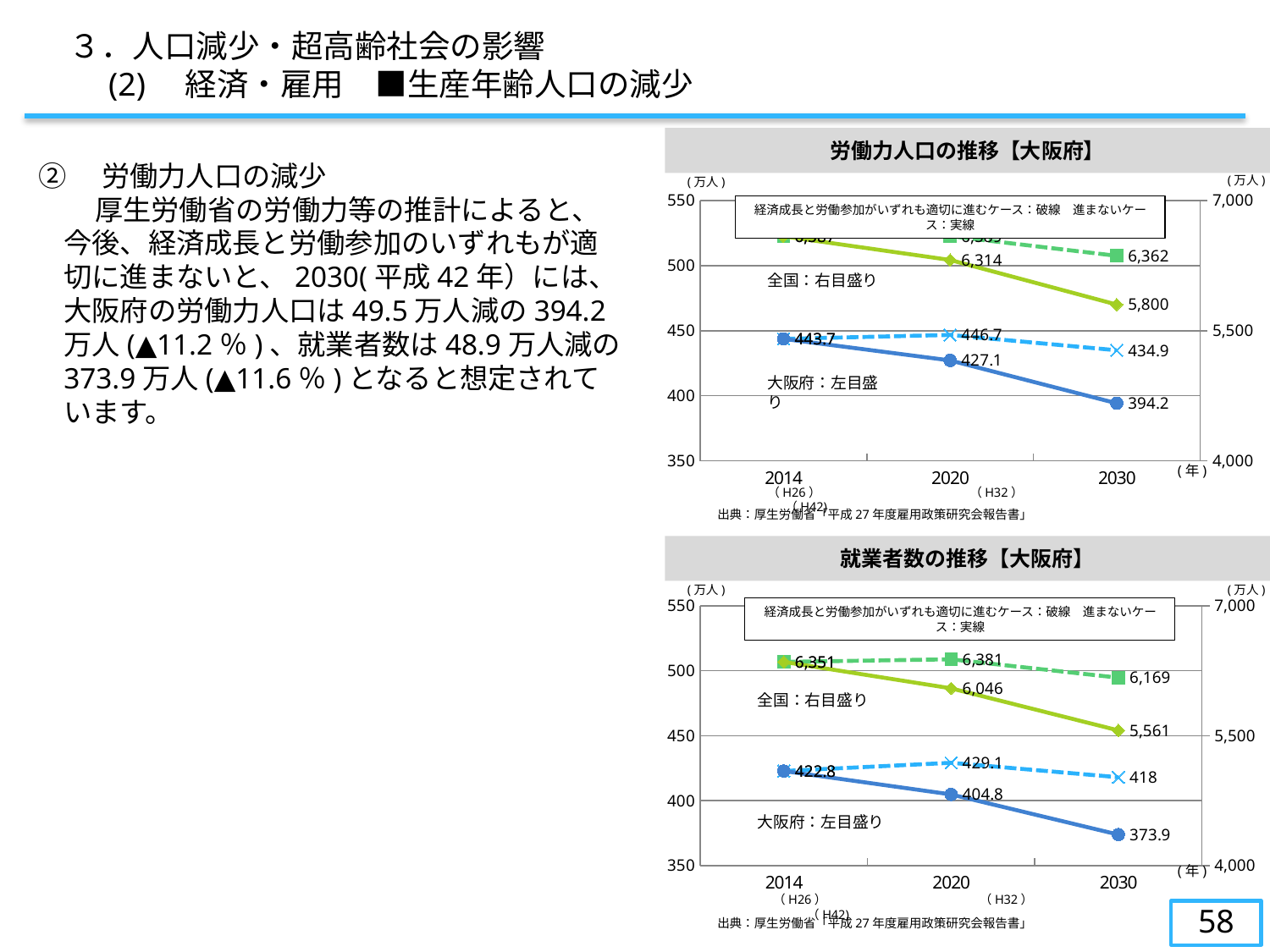
In the bottom chart (就業者数の推移【大阪府】), what is the 全国 value in 2020 on the dashed line? 6,381 In the top chart (労働力人口の推移【大阪府】), what is the value for 大阪府 in 2030 in the case where growth and participation do not progress (solid line)? 394.2 What kind of chart is the bottom chart (就業者数の推移【大阪府】)? line chart In the top chart (労働力人口の推移【大阪府】), what is the 全国 value in 2030 on the solid line? 5,800 In the top chart (労働力人口の推移【大阪府】), what is the difference between the 大阪府 dashed-line value and solid-line value in 2030? 40.7 In the top chart (労働力人口の推移【大阪府】), what is the 全国 value in 2030 on the dashed line? 6,362 In the top chart (労働力人口の推移【大阪府】), what is the value for 大阪府 in 2020 on the solid line? 427.1 In the bottom chart (就業者数の推移【大阪府】), does the 大阪府 solid line rise or fall from 2014 to 2030? fall How many years are plotted on the x axis of the top chart (労働力人口の推移【大阪府】)? 3 In the bottom chart (就業者数の推移【大阪府】), what is the difference between the 全国 solid-line values in 2014 and 2030? 790 In the bottom chart (就業者数の推移【大阪府】), which is larger in 2030: the 大阪府 dashed-line value or the solid-line value? dashed-line value (418) In the bottom chart (就業者数の推移【大阪府】), what is the value for 大阪府 in 2030 on the solid line? 373.9